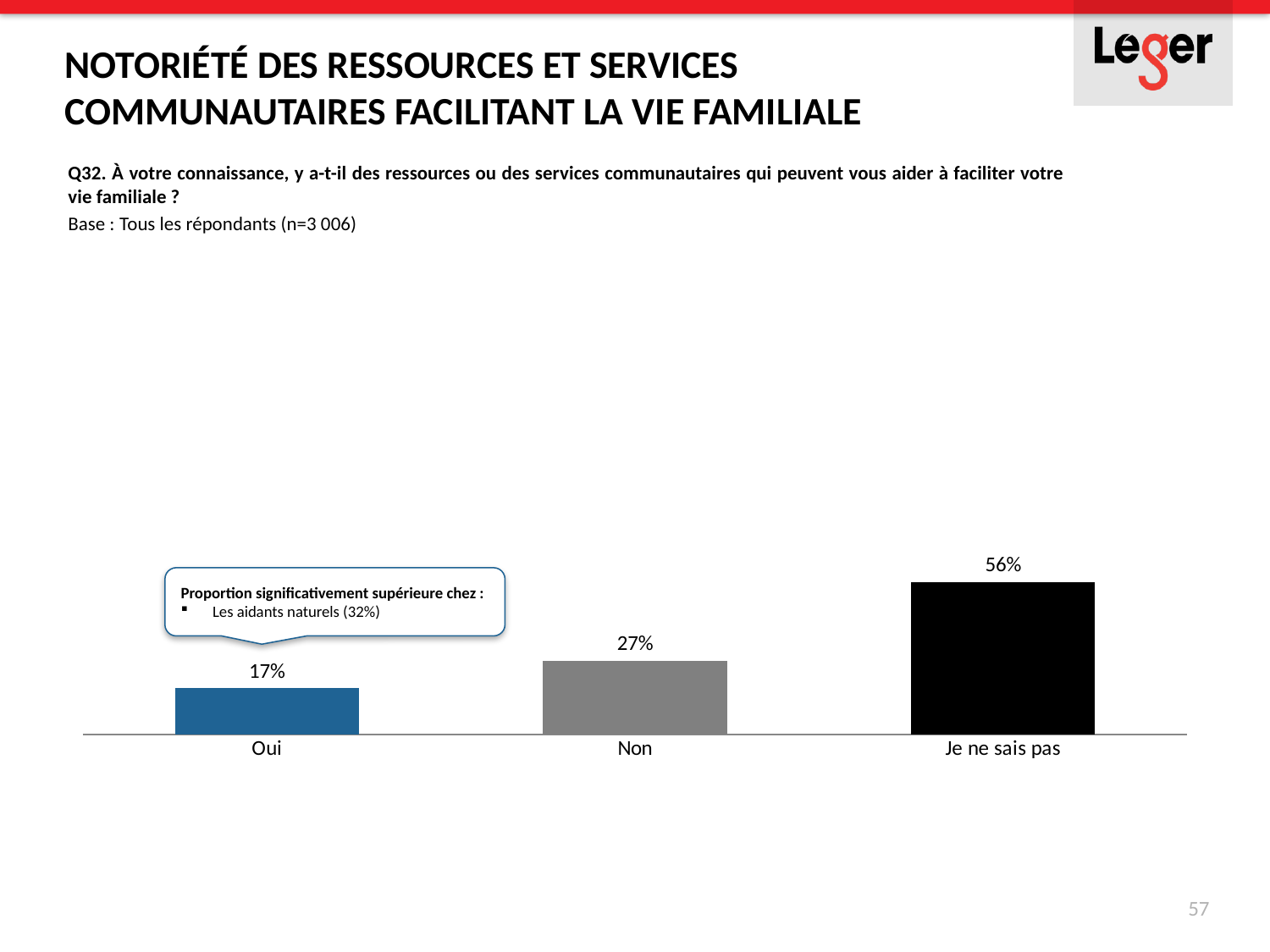
Which category has the highest value? Je ne sais pas What is the value for "Je ne sais pas"? 56% Which category has the lowest value? Oui Do the values rise or fall from left to right across the categories? Rise According to the callout box, which group has a significantly higher proportion for "Oui", and what is its value? Les aidants naturels (32%) What is the value for "Non"? 27% Which is larger, the value for "Oui" or the value for "Non"? Non What kind of chart is shown on the slide? Bar chart How many categories are shown in the chart? 3 What is the difference between the values for "Non" and "Oui"? 10% What is the value for "Oui"? 17% What is the difference between the values for "Je ne sais pas" and "Non"? 29%